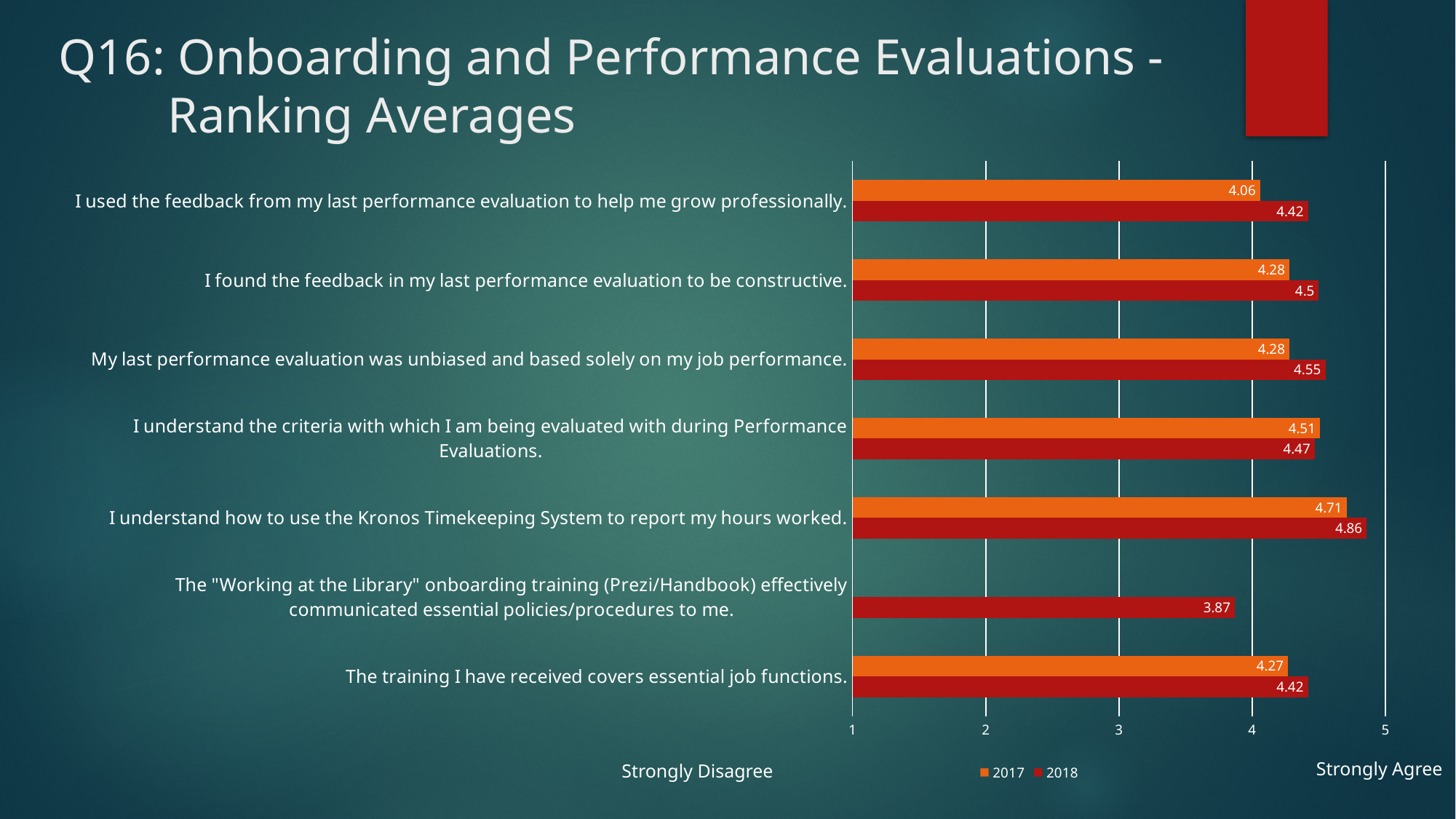
Which statement has the highest 2017 value? I understand how to use the Kronos Timekeeping System to report my hours worked. How many series does the legend list? 2 What is the difference between the 2018 and 2017 values for "I used the feedback from my last performance evaluation to help me grow professionally."? 0.36 Is the 2018 value for "The "Working at the Library" onboarding training (Prezi/Handbook) effectively communicated essential policies/procedures to me." greater or less than 4? less Which series is shown in orange? 2017 How many statements (categories) are shown on the chart? 7 For "I understand the criteria with which I am being evaluated with during Performance Evaluations.", which year has the larger value, 2017 or 2018? 2017 What is the 2018 value for "The "Working at the Library" onboarding training (Prezi/Handbook) effectively communicated essential policies/procedures to me."? 3.87 What kind of chart is shown on the slide? bar chart What is the 2017 value for "I used the feedback from my last performance evaluation to help me grow professionally."? 4.06 Which statement has the lowest 2018 value? The "Working at the Library" onboarding training (Prezi/Handbook) effectively communicated essential policies/procedures to me. What is the 2018 value for "I understand how to use the Kronos Timekeeping System to report my hours worked."? 4.86